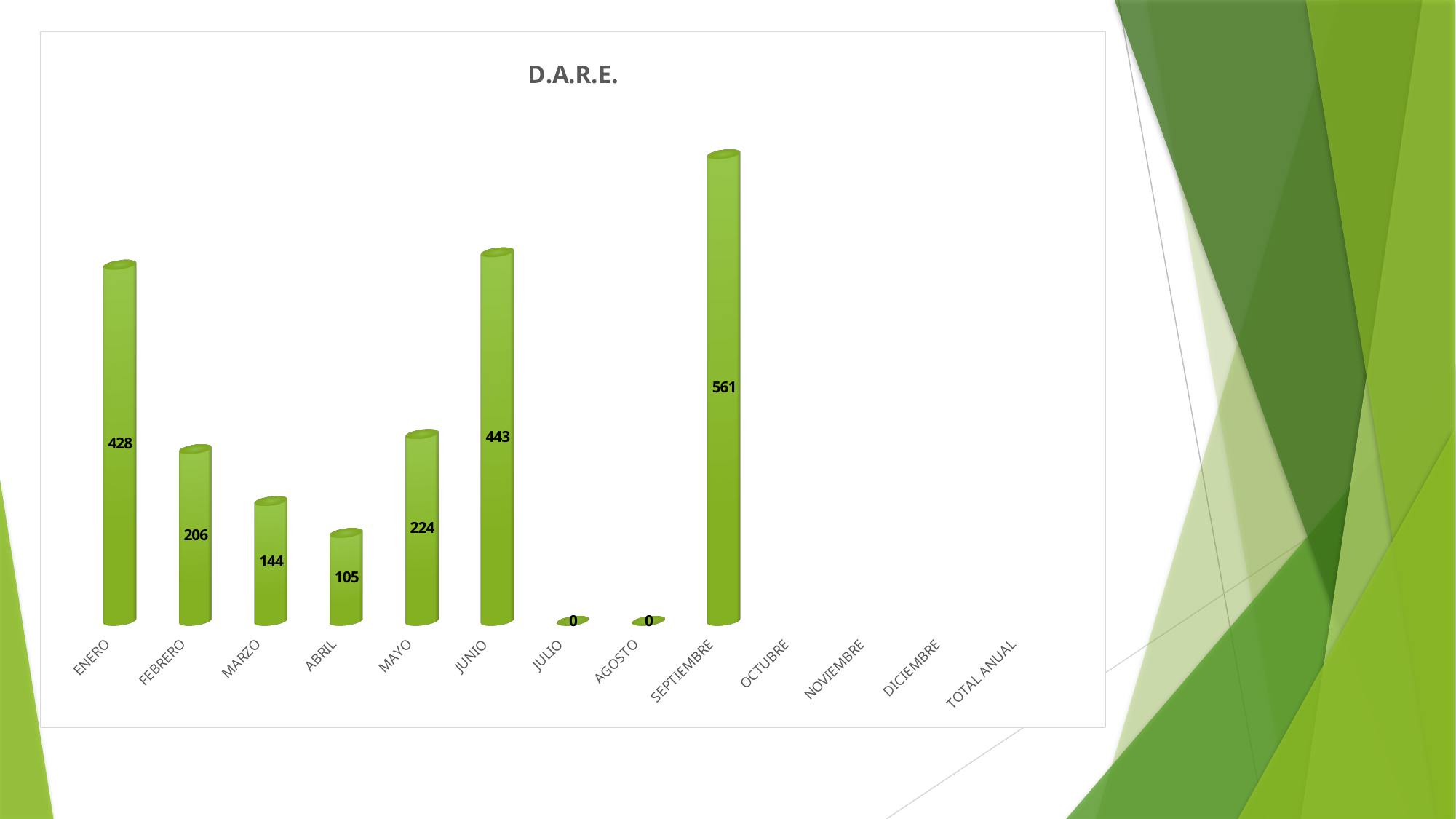
How many category labels are shown on the x axis? 13 What is the value for ABRIL? 105 What is the title of the chart? D.A.R.E. What is the difference between the values for FEBRERO and MARZO? 62 Which month has the highest value? SEPTIEMBRE What is the value for SEPTIEMBRE? 561 What kind of chart is this? Bar chart What is the value for MAYO? 224 Which is larger, the value for ENERO or the value for MAYO? ENERO Among the months with a non-zero value, which has the lowest? ABRIL What is the value for JULIO? 0 What is the difference between the values for JUNIO and ENERO? 15